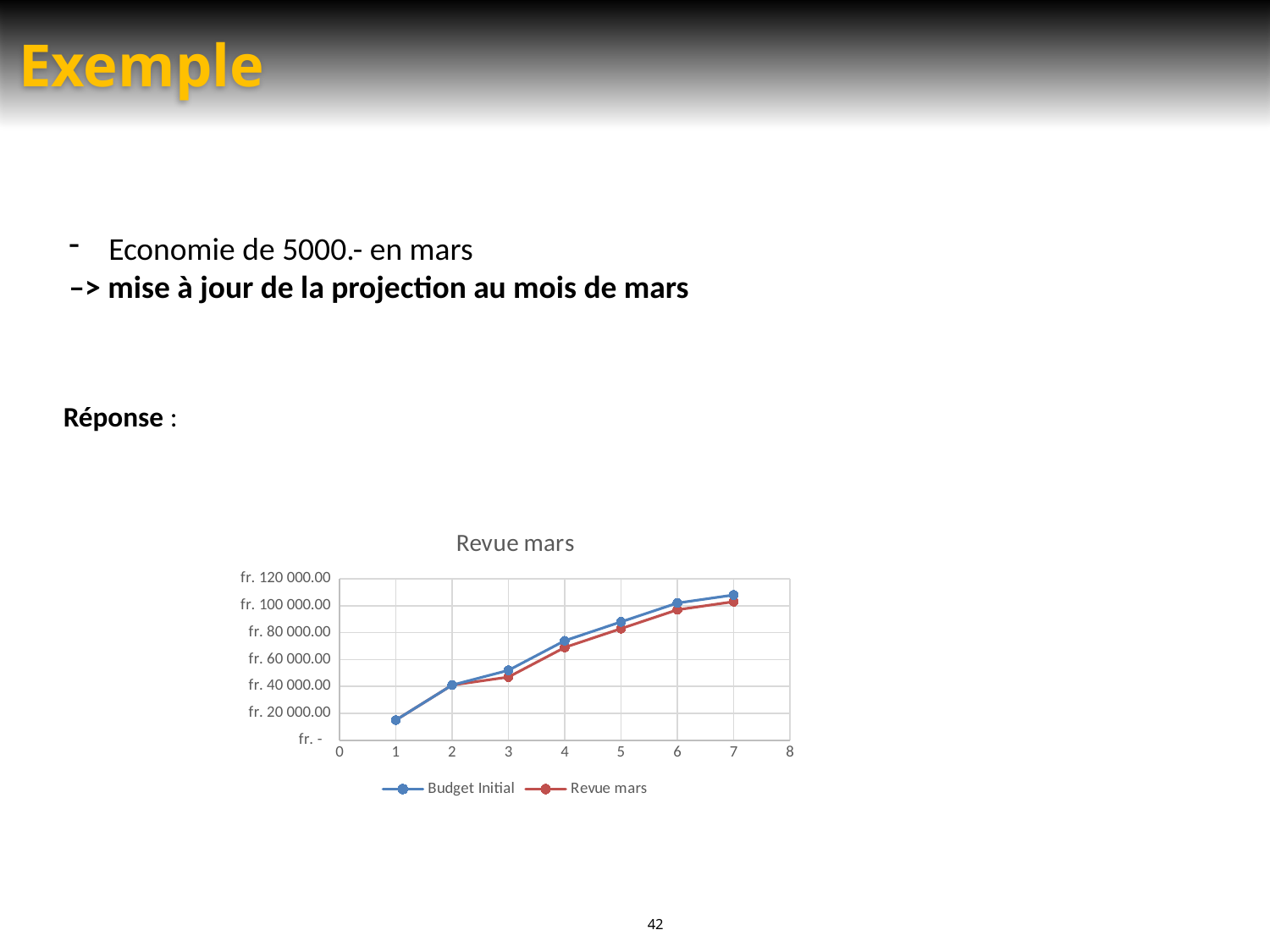
What are the two series named in the legend of the chart? Budget Initial and Revue mars Do the values of the Budget Initial series rise or fall as the x axis goes from 1 to 7? rise What kind of chart is shown under the title "Revue mars"? line chart How many data points are plotted for the Budget Initial series? 7 Is the Budget Initial value at x = 1 greater or less than fr. 20 000.00? less What is the title of the chart on the slide? Revue mars How many series does the legend of the "Revue mars" chart list? 2 Is the Budget Initial value at x = 5 greater or less than fr. 80 000.00? greater Is the Budget Initial value at x = 7 greater or less than fr. 100 000.00? greater At x = 7, which series has the higher value, Budget Initial or Revue mars? Budget Initial